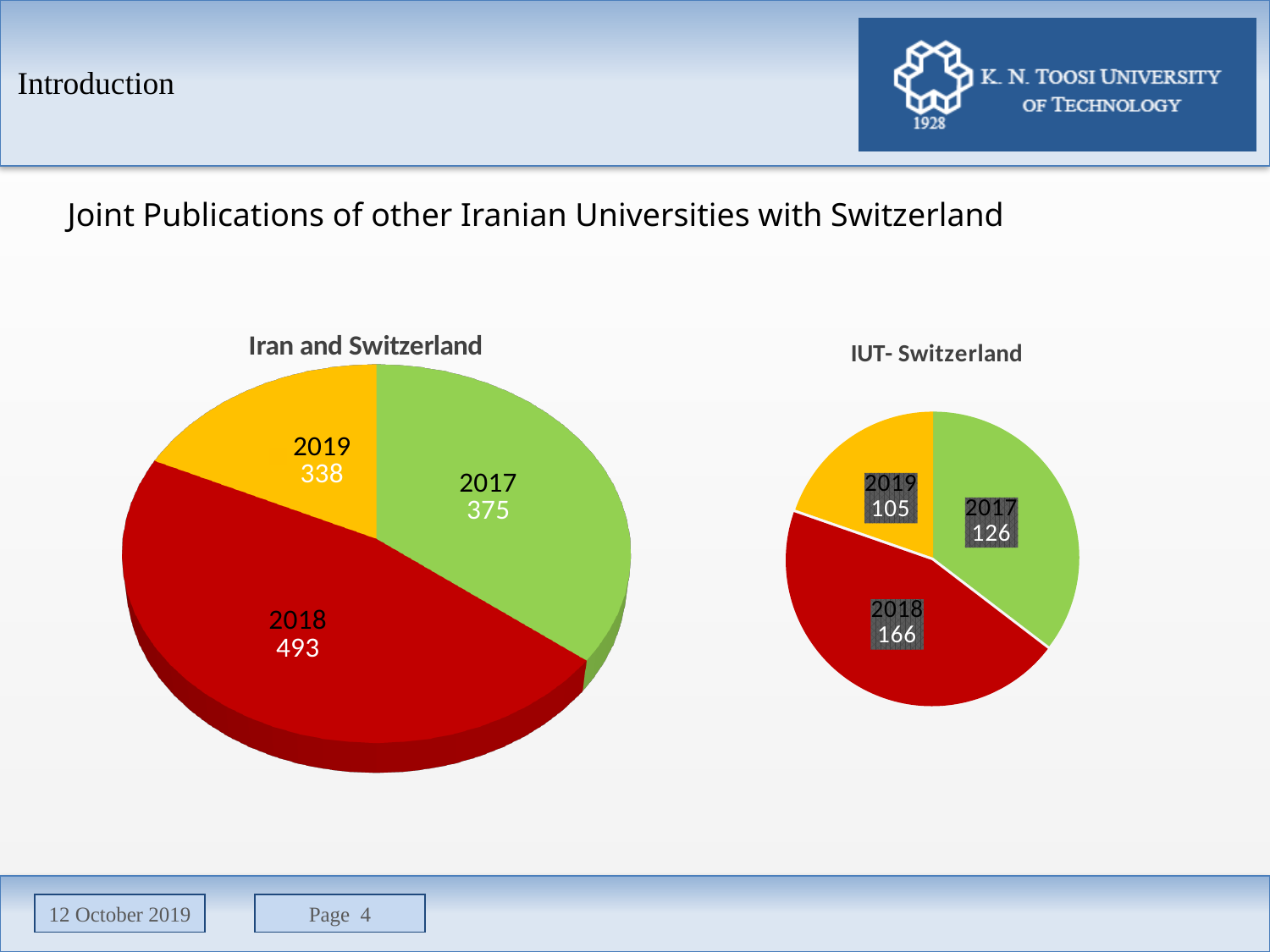
In the 'Iran and Switzerland' chart, which year has the largest slice? 2018 In the 'IUT- Switzerland' chart, which year has the smallest slice? 2019 What is the total of all slices in the 'IUT- Switzerland' chart? 397 What type of chart is the 'Iran and Switzerland' chart? pie chart In the 'Iran and Switzerland' chart, what is the value for 2019? 338 How many slices does the 'Iran and Switzerland' pie chart have? 3 In the 'IUT- Switzerland' chart, which is larger, the value for 2017 or the value for 2019? 2017 In the 'IUT- Switzerland' chart, what is the value for 2017? 126 In the 'Iran and Switzerland' chart, what is the value for 2018? 493 In the 'IUT- Switzerland' chart, what is the value for 2018? 166 In the 'Iran and Switzerland' chart, what is the difference between the values for 2018 and 2017? 118 In the 'IUT- Switzerland' chart, what is the difference between the values for 2018 and 2019? 61